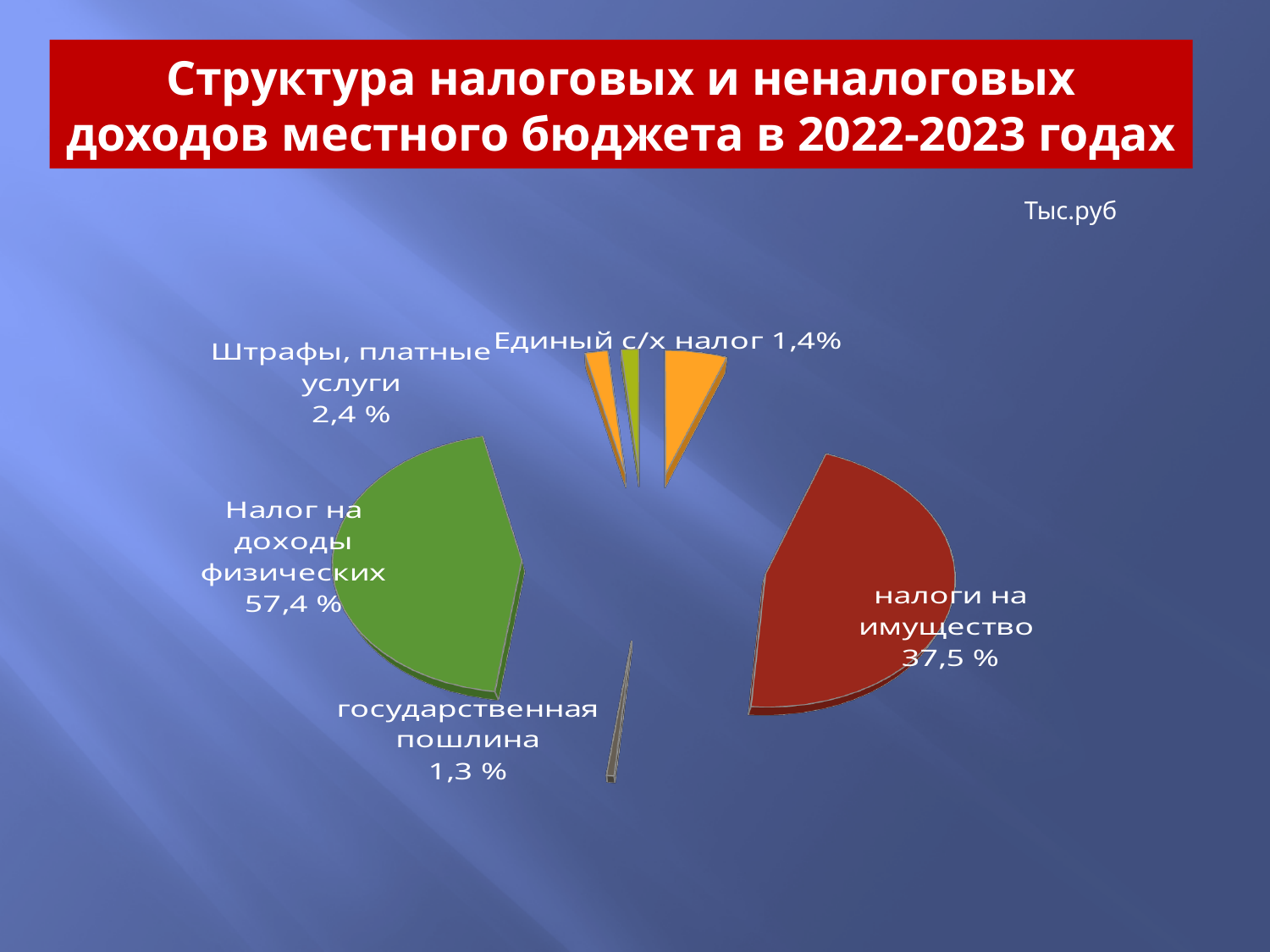
What is the title of the slide? Структура налоговых и неналоговых доходов местного бюджета в 2022-2023 годах What share of the pie does "Единый с/х налог" have? 1,4% What is the difference in percentage points between "Налог на доходы физических" and "налоги на имущество"? 19,9 What share of the pie does "Налог на доходы физических" have? 57,4 % How many slices does the pie chart have? 6 What share of the pie does "Штрафы, платные услуги" have? 2,4 % What type of chart is shown on the slide? Pie chart What share of the pie does "налоги на имущество" have? 37,5 % What share of the pie does "государственная пошлина" have? 1,3 % Which category has the smallest slice of the pie? государственная пошлина Which is larger: the share for "налоги на имущество" or the share for "Штрафы, платные услуги"? налоги на имущество Which category has the largest slice of the pie? Налог на доходы физических